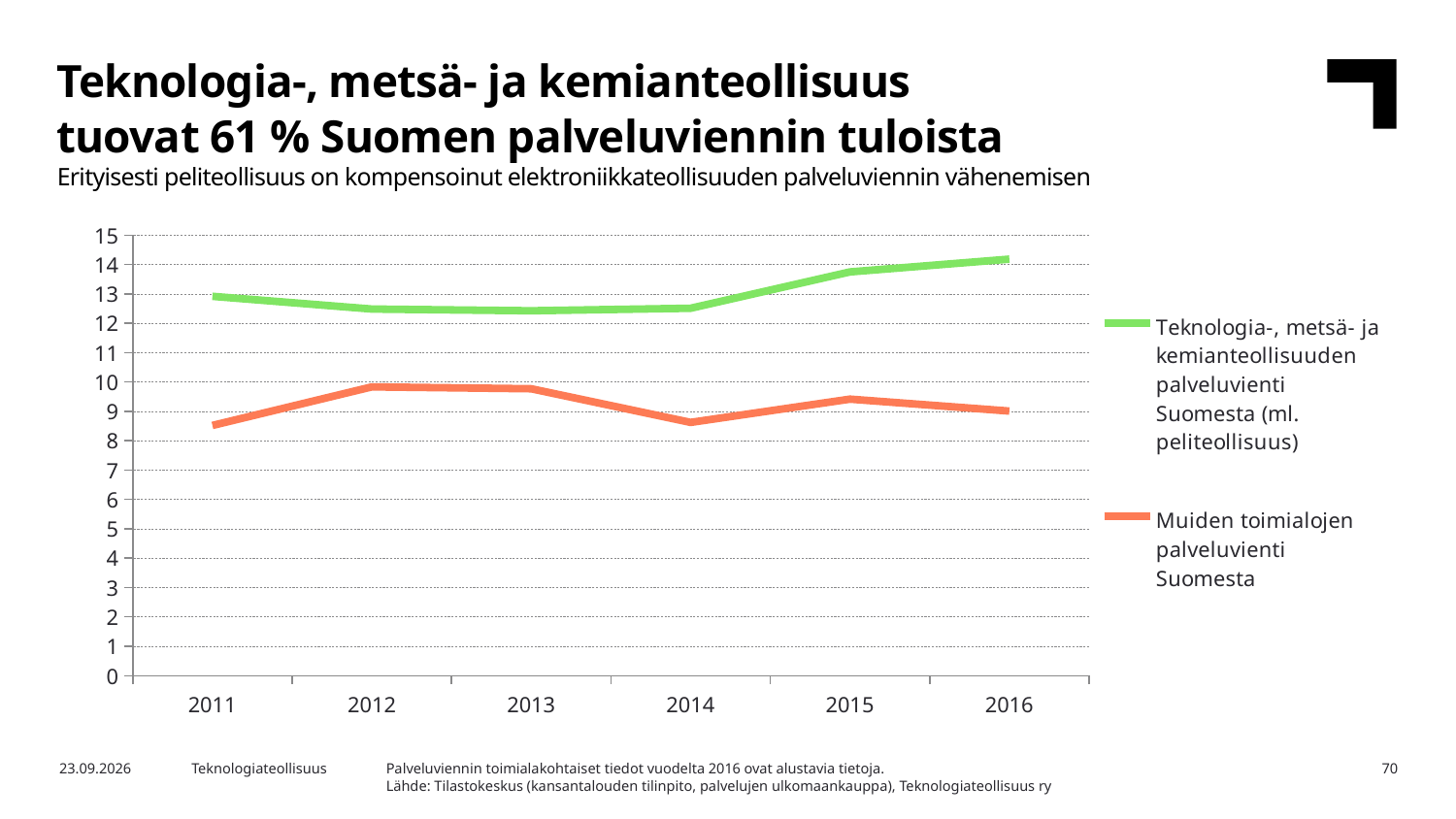
In 2015, which series has the larger value, the green one or the orange one? the green series (Teknologia-, metsä- ja kemianteollisuuden palveluvienti Suomesta) Does the green series rise or fall from 2014 to 2016? rise Is the value for the green series in 2011 greater or less than 12? greater Is the value for the green series in 2016 greater or less than 13? greater Does the orange series rise or fall from 2012 to 2014? fall What colour is the line for Muiden toimialojen palveluvienti Suomesta? orange Is the value for the orange series (Muiden toimialojen palveluvienti Suomesta) in 2014 greater or less than 9? less What kind of chart is shown on the slide? line chart How many years are shown on the x axis? 6 Which year has the highest value for the green series (Teknologia-, metsä- ja kemianteollisuuden palveluvienti Suomesta)? 2016 How many series does the legend list? 2